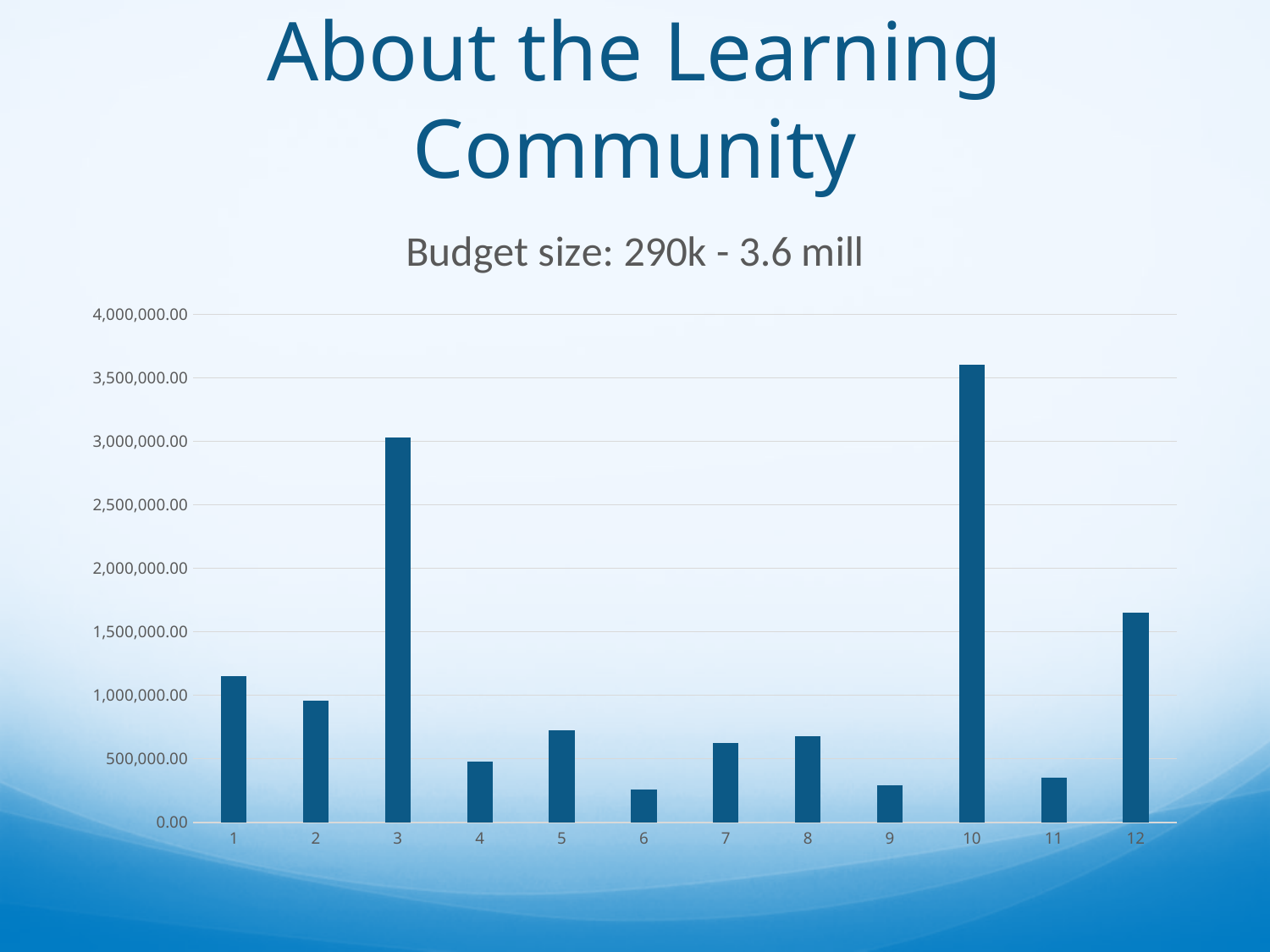
Which is larger, the value for category 1 or the value for category 2? 1 How many categories are shown on the x axis of the chart? 12 Which category has the highest bar in the chart? 10 Is the value for category 3 greater or less than 2,500,000.00? greater What is the highest value shown on the y axis of the chart? 4,000,000.00 Is the value for category 12 greater or less than 1,500,000.00? greater What kind of chart is shown on the slide? bar chart Is the value for category 1 greater or less than 1,000,000.00? greater Which is larger, the value for category 3 or the value for category 12? 3